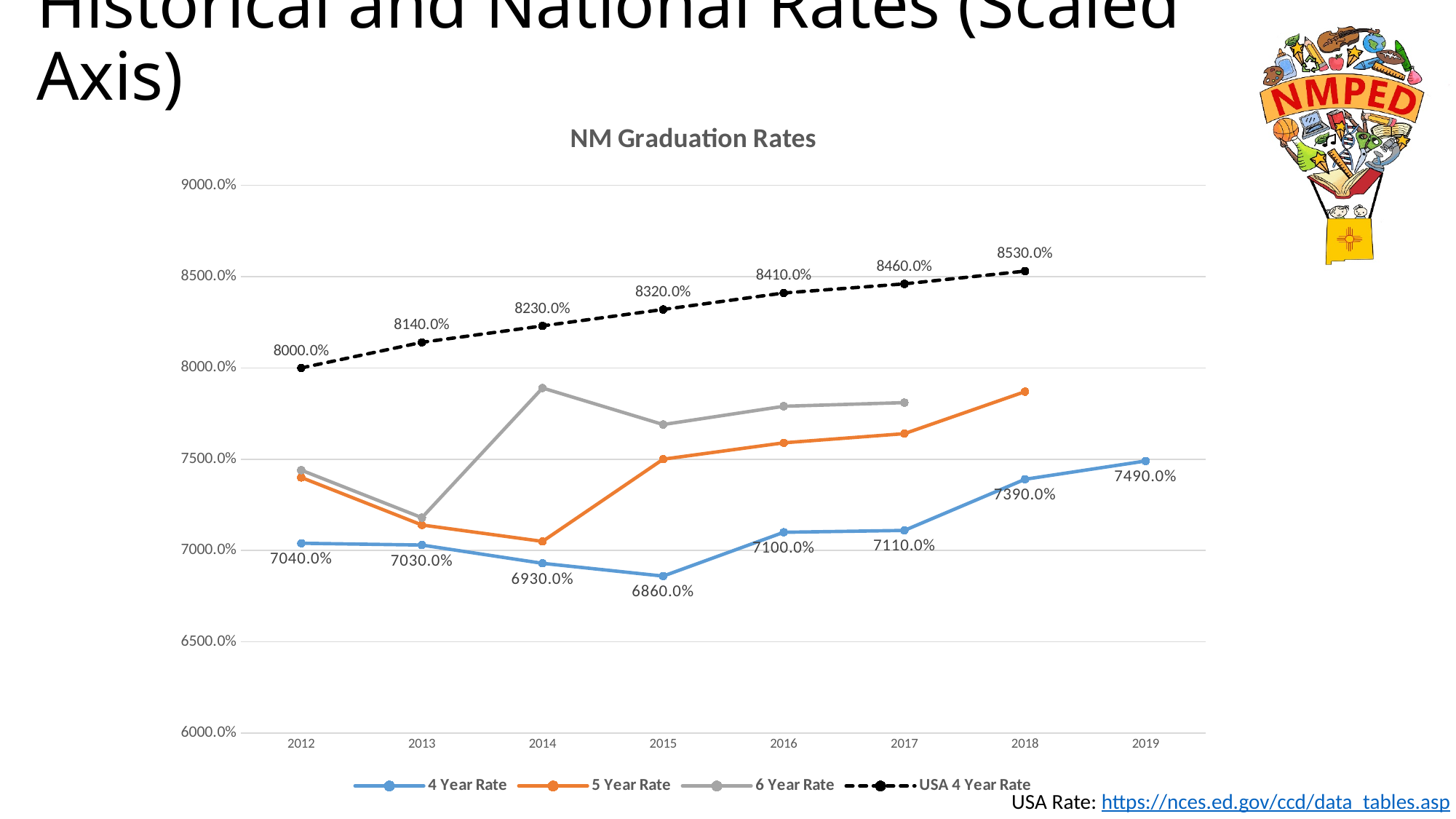
Is the 5 Year Rate value for 2018 greater or less than 8000.0%? less What is the USA 4 Year Rate value for 2018? 8530.0% Which is larger in 2014: the 6 Year Rate or the 5 Year Rate? 6 Year Rate What is the 4 Year Rate value for 2019? 7490.0% What is the 4 Year Rate value for 2015? 6860.0% How many years are shown on the x axis? 8 In which year is the 4 Year Rate lowest? 2015 In which year is the USA 4 Year Rate highest? 2018 What is the difference between the USA 4 Year Rate and the 4 Year Rate in 2018? 1140.0% What is the title of the chart? NM Graduation Rates How many series does the legend list? 4 What type of chart is shown on the slide? line chart